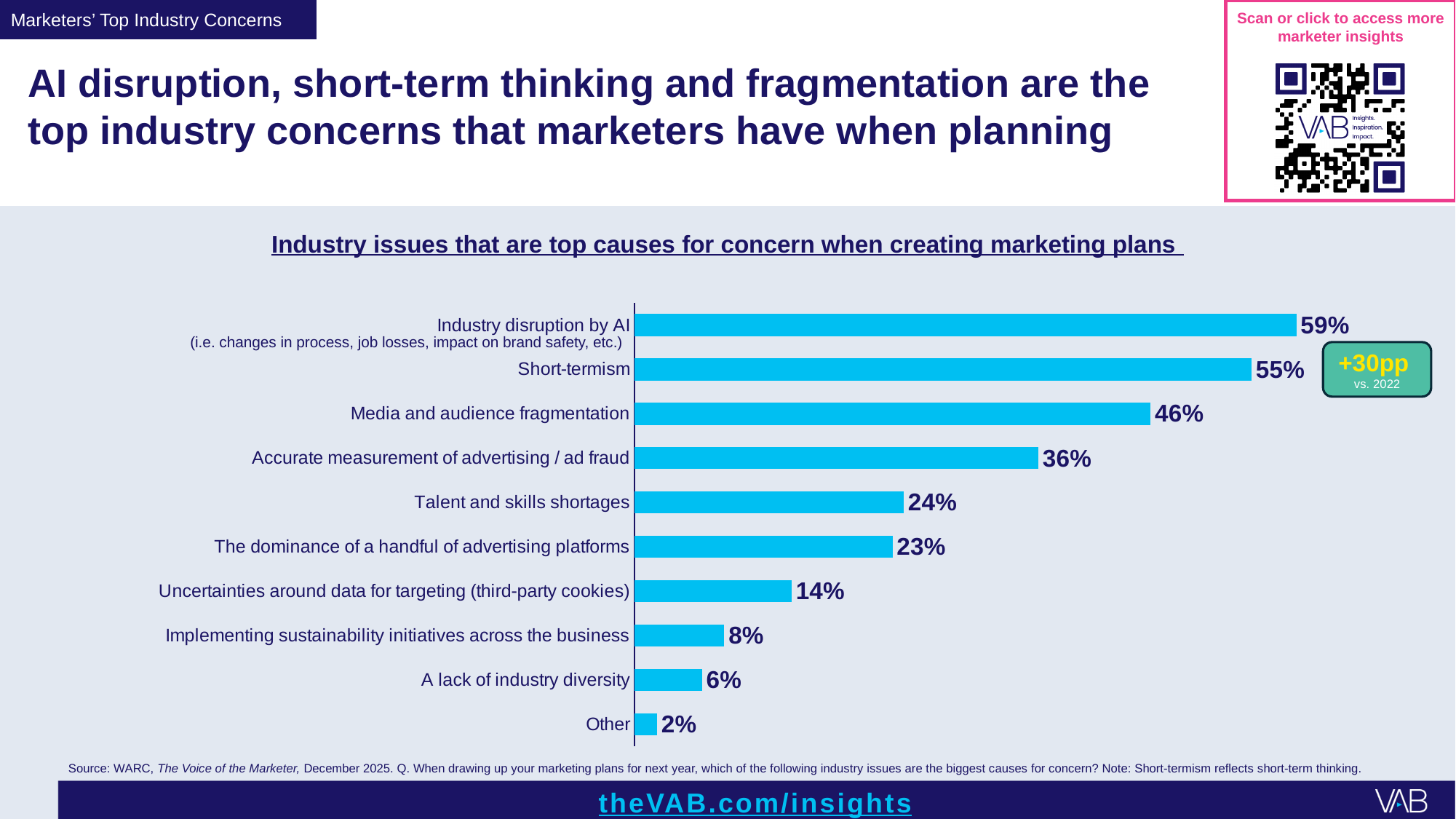
What percentage of marketers cite Industry disruption by AI as a top cause for concern? 59% What is the difference between Accurate measurement of advertising / ad fraud and Talent and skills shortages? 12% What is the difference between the values for Short-termism and Media and audience fragmentation? 9% Which industry issue has the highest percentage on the chart? Industry disruption by AI What change vs. 2022 is shown in the callout next to the Short-termism bar? +30pp What is the value shown for Uncertainties around data for targeting (third-party cookies)? 14% Which is larger: Talent and skills shortages or The dominance of a handful of advertising platforms? Talent and skills shortages Which category has the lowest value on the chart? Other How many industry issues (categories) are plotted on the chart? 10 What is the title of the chart? Industry issues that are top causes for concern when creating marketing plans What is the value shown for Media and audience fragmentation? 46% What type of chart is used on this slide? Bar chart